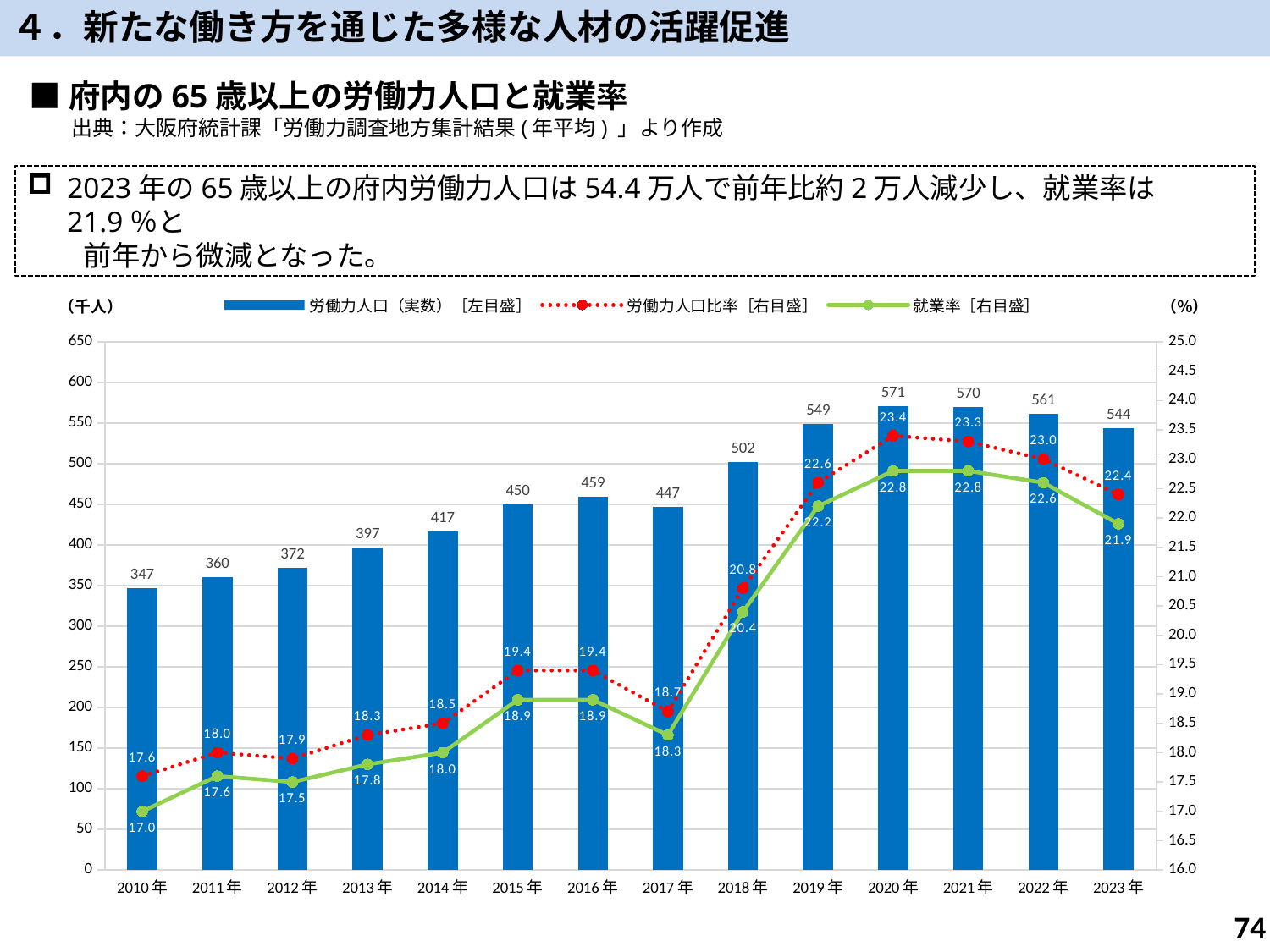
2019年の労働力人口比率の値はいくつですか？ 22.6 労働力人口（実数）が最も少ない年はどれですか？ 2010年 2018年の労働力人口（実数）は500より大きいですか、小さいですか？ 大きい 労働力人口（実数）はどのような種類のグラフで示されていますか？ 棒グラフ 2017年と2018年では、どちらの労働力人口（実数）が多いですか？ 2018年 労働力人口（実数）が最も多い年はどれですか？ 2020年 2010年から2016年にかけて、労働力人口（実数）は増加していますか、減少していますか？ 増加 2023年の労働力人口（実数）の値はいくつですか？ 544 2022年と2023年の労働力人口（実数）の差はいくつですか？ 17 2020年の就業率の値はいくつですか？ 22.8 横軸には何年分のデータが示されていますか？ 14 凡例にはいくつの系列が示されていますか？ 3